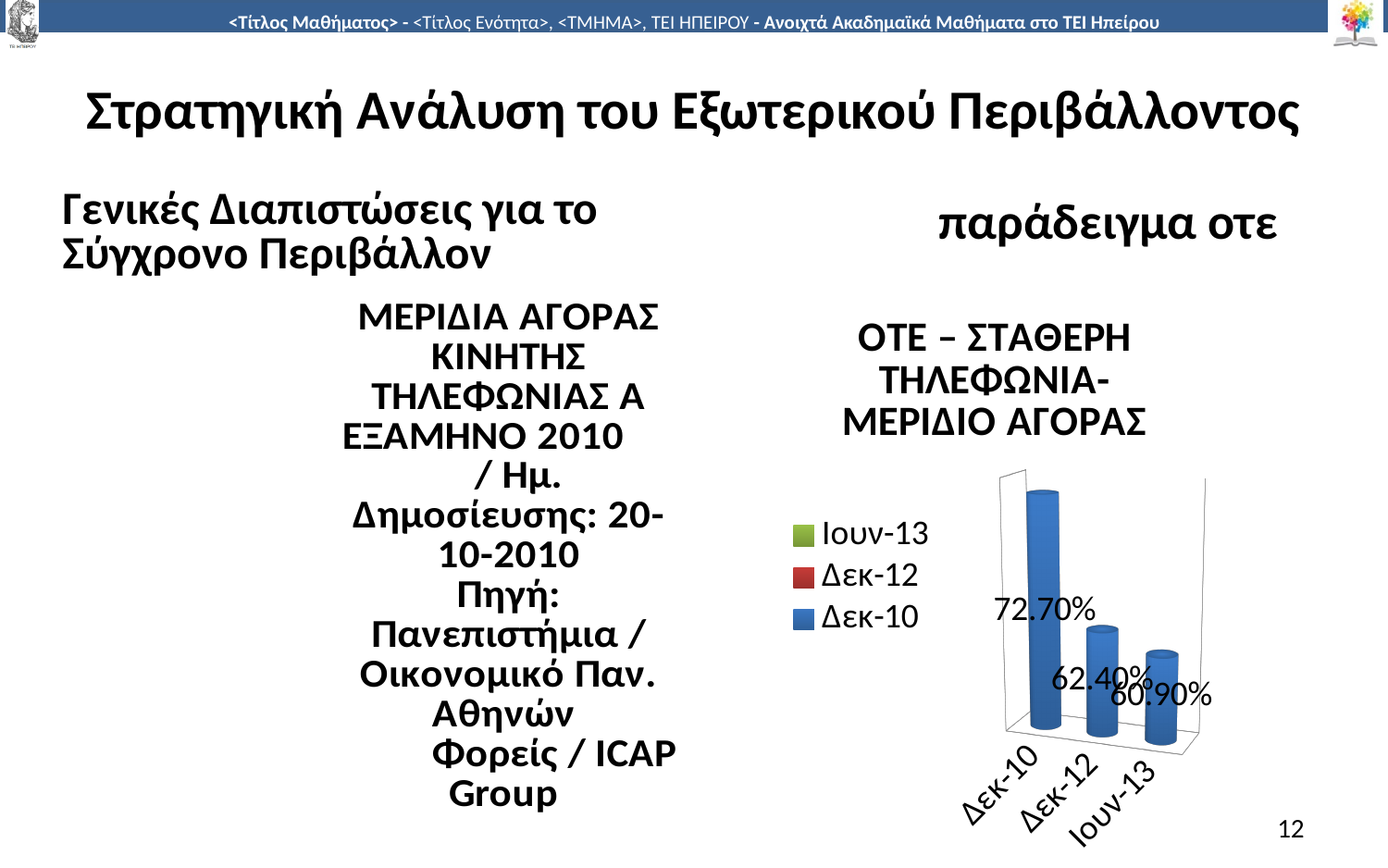
In the chart titled 'ΟΤΕ – ΣΤΑΘΕΡΗ ΤΗΛΕΦΩΝΙΑ- ΜΕΡΙΔΙΟ ΑΓΟΡΑΣ', what is the difference between the values for Δεκ-10 and Δεκ-12? 10.30 percentage points In the chart titled 'ΟΤΕ – ΣΤΑΘΕΡΗ ΤΗΛΕΦΩΝΙΑ- ΜΕΡΙΔΙΟ ΑΓΟΡΑΣ', which category has the highest value? Δεκ-10 In the chart titled 'ΟΤΕ – ΣΤΑΘΕΡΗ ΤΗΛΕΦΩΝΙΑ- ΜΕΡΙΔΙΟ ΑΓΟΡΑΣ', how many categories are plotted? 3 In the chart titled 'ΟΤΕ – ΣΤΑΘΕΡΗ ΤΗΛΕΦΩΝΙΑ- ΜΕΡΙΔΙΟ ΑΓΟΡΑΣ', what is the difference between the values for Δεκ-12 and Ιουν-13? 1.50 percentage points In the chart titled 'ΟΤΕ – ΣΤΑΘΕΡΗ ΤΗΛΕΦΩΝΙΑ- ΜΕΡΙΔΙΟ ΑΓΟΡΑΣ', what is the value for Δεκ-12? 62.40% In the chart titled 'ΟΤΕ – ΣΤΑΘΕΡΗ ΤΗΛΕΦΩΝΙΑ- ΜΕΡΙΔΙΟ ΑΓΟΡΑΣ', do the values rise or fall from Δεκ-10 to Ιουν-13? Fall In the chart titled 'ΟΤΕ – ΣΤΑΘΕΡΗ ΤΗΛΕΦΩΝΙΑ- ΜΕΡΙΔΙΟ ΑΓΟΡΑΣ', how many entries does the legend list? 3 In the chart titled 'ΟΤΕ – ΣΤΑΘΕΡΗ ΤΗΛΕΦΩΝΙΑ- ΜΕΡΙΔΙΟ ΑΓΟΡΑΣ', which is larger, the value for Δεκ-12 or the value for Ιουν-13? Δεκ-12 What kind of chart is the one titled 'ΟΤΕ – ΣΤΑΘΕΡΗ ΤΗΛΕΦΩΝΙΑ- ΜΕΡΙΔΙΟ ΑΓΟΡΑΣ'? Bar chart In the chart titled 'ΟΤΕ – ΣΤΑΘΕΡΗ ΤΗΛΕΦΩΝΙΑ- ΜΕΡΙΔΙΟ ΑΓΟΡΑΣ', what is the value for Ιουν-13? 60.90% In the chart titled 'ΟΤΕ – ΣΤΑΘΕΡΗ ΤΗΛΕΦΩΝΙΑ- ΜΕΡΙΔΙΟ ΑΓΟΡΑΣ', what is the value for Δεκ-10? 72.70% In the chart titled 'ΟΤΕ – ΣΤΑΘΕΡΗ ΤΗΛΕΦΩΝΙΑ- ΜΕΡΙΔΙΟ ΑΓΟΡΑΣ', which category has the lowest value? Ιουν-13